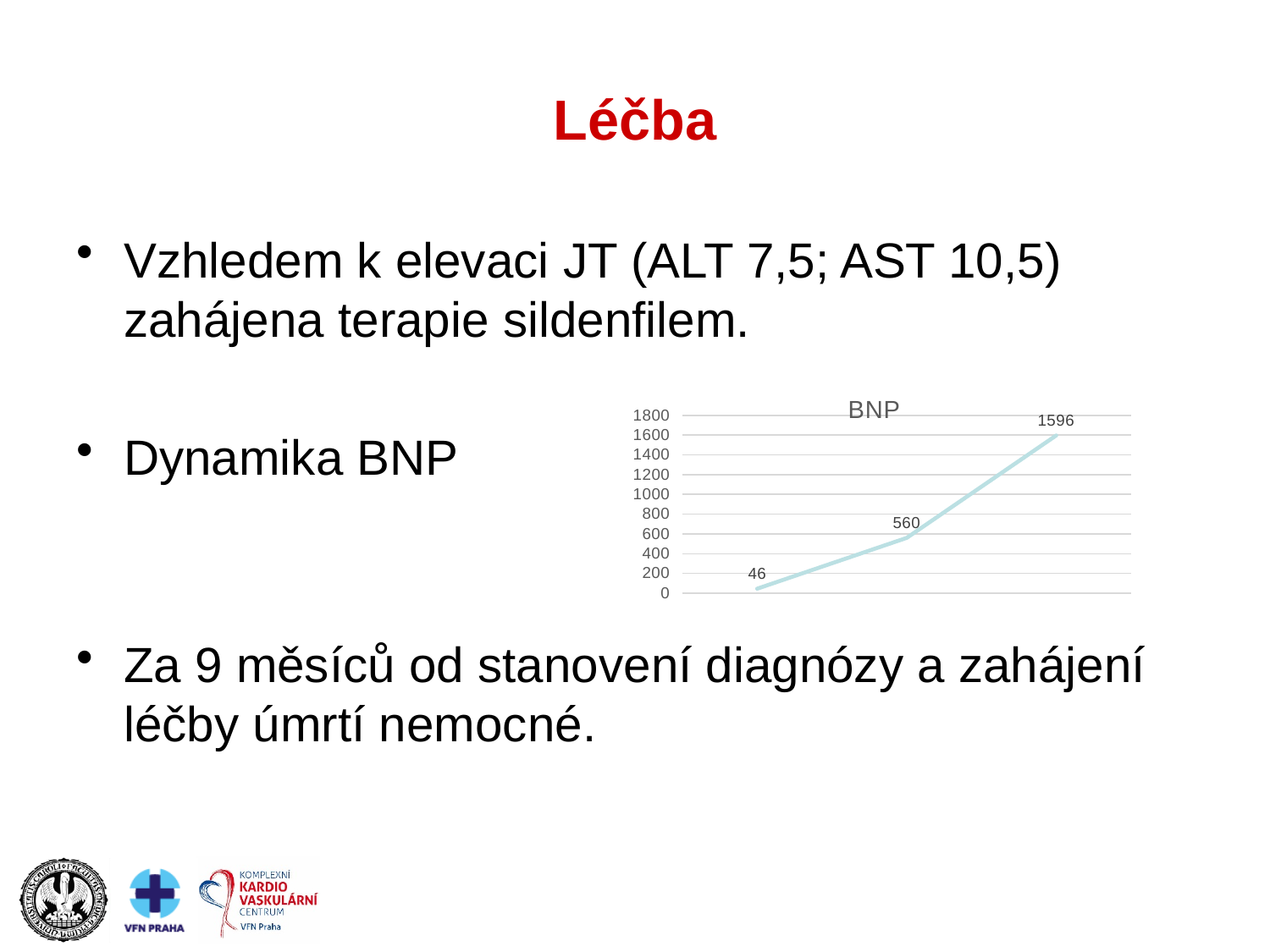
What is the value of the first data point on the BNP chart? 46 What is the lowest value plotted on the BNP chart? 46 What is the highest value plotted on the BNP chart? 1596 Is the value of the second data point on the BNP chart greater or less than 600? less What kind of chart is shown on the slide? line chart What is the difference between the second and the first data point on the BNP chart? 514 How many data points are plotted on the BNP chart? 3 What is the difference between the last and the first data point on the BNP chart? 1550 What is the value of the last data point on the BNP chart? 1596 Do the BNP values rise or fall from left to right along the chart? rise What is the title of the chart? BNP What is the value of the second data point on the BNP chart? 560